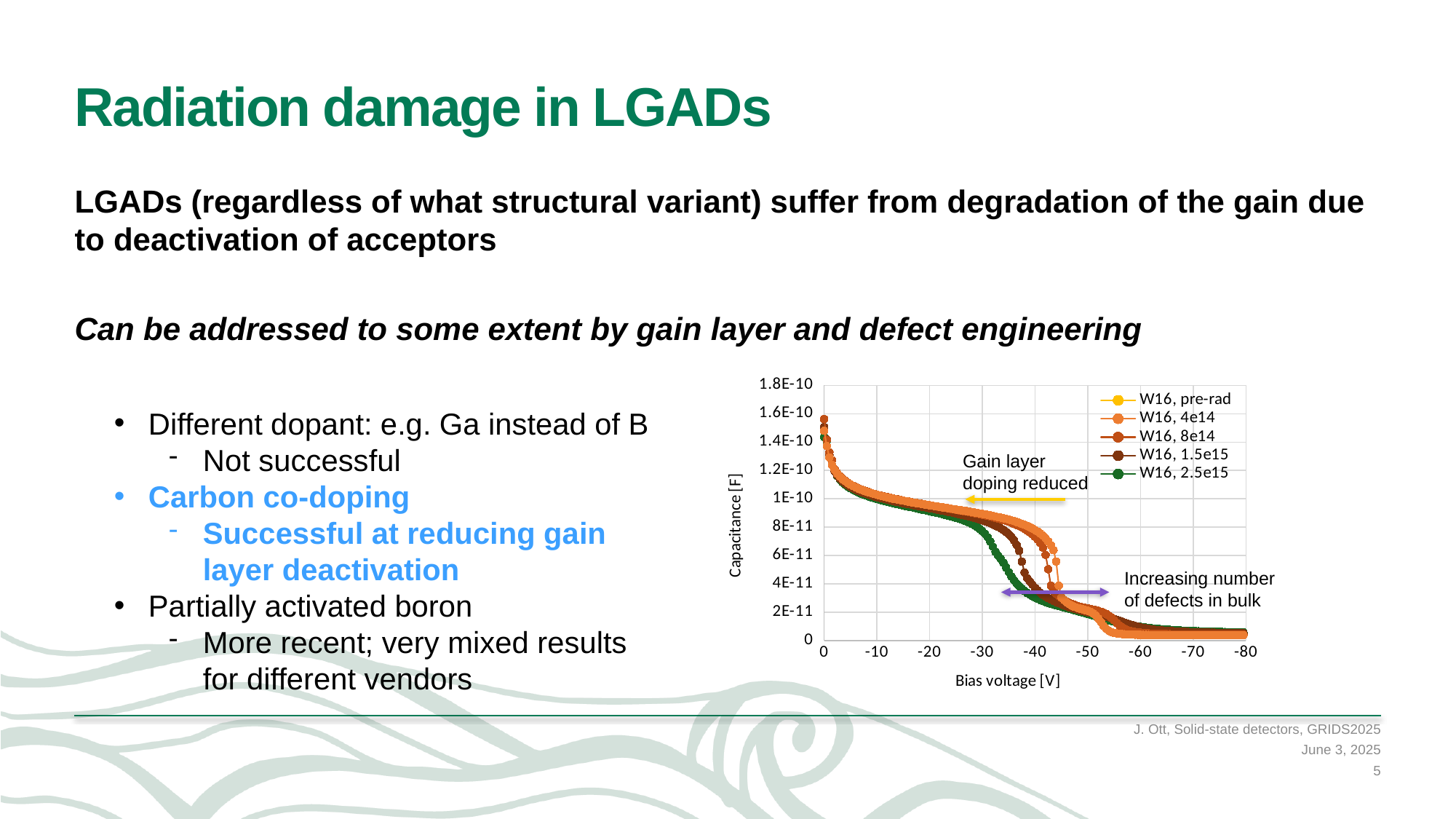
Which series shows its capacitance drop at the smallest bias voltage magnitude? W16, 2.5e15 Does the capacitance rise or fall as the bias voltage goes from 0 to -80 V? Fall At a bias voltage of -40 V, which series has the higher capacitance, W16, 4e14 or W16, 2.5e15? W16, 4e14 At a bias voltage of -50 V, is the capacitance of the curves greater or less than 6E-11? less What is the label of the y axis of the chart? Capacitance [F] At a bias voltage of -70 V, is the capacitance of the curves greater or less than 2E-11? less What is the highest value shown on the y axis of the chart? 1.8E-10 How many series does the legend of the capacitance chart list? 5 At a bias voltage of -30 V, is the capacitance of the curves greater or less than 6E-11? greater How many tick labels are shown on the x axis of the chart? 9 Which series in the legend is drawn in green? W16, 2.5e15 What kind of chart is shown on the slide? Line chart